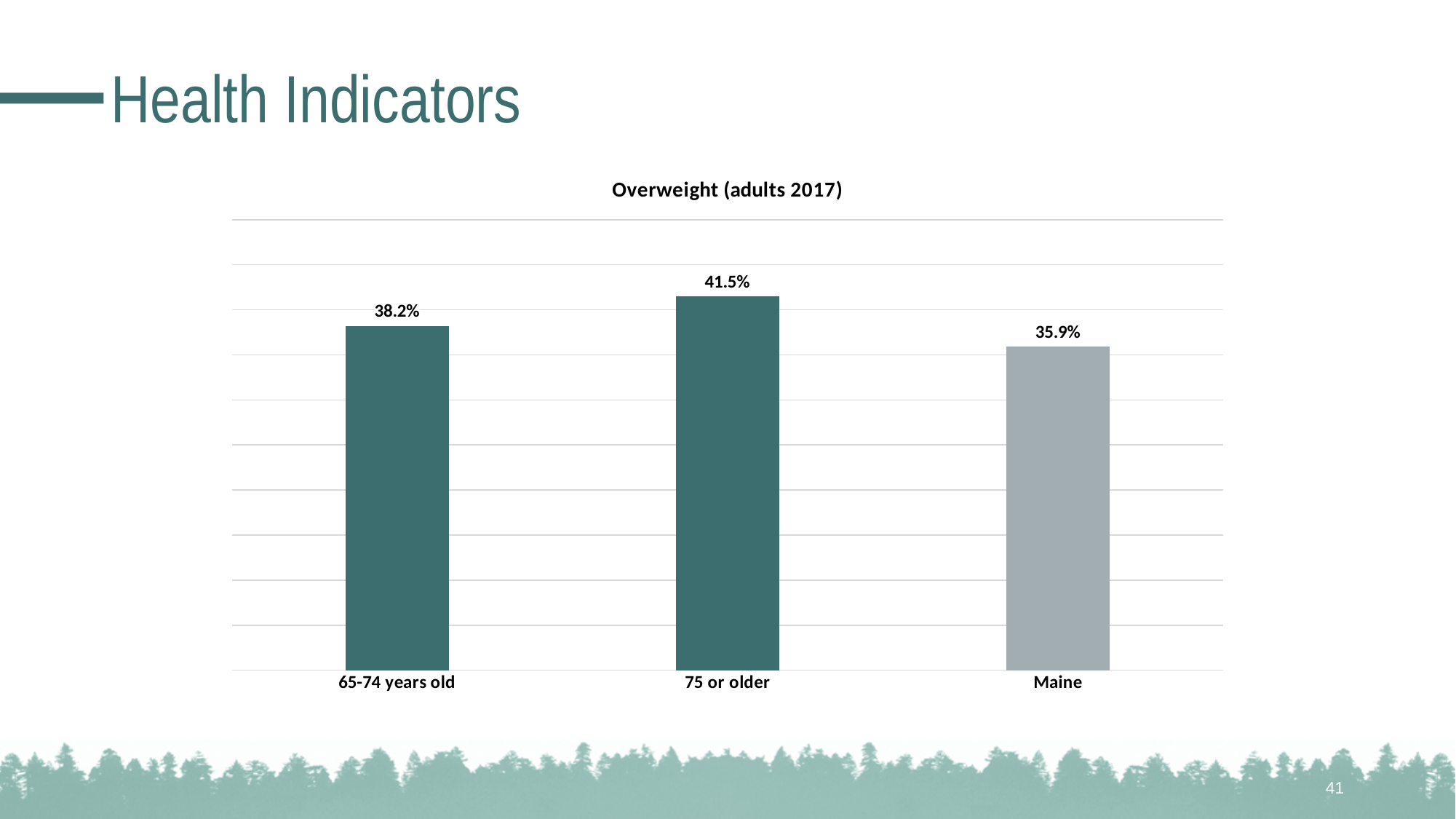
What is the overweight percentage for Maine? 35.9% What is the difference in overweight percentage between the 75 or older group and Maine? 5.6% Which has a higher overweight percentage, 65-74 years old or Maine? 65-74 years old What is the title of the chart? Overweight (adults 2017) What kind of chart is shown on the slide? Bar chart Which category has the lowest overweight percentage? Maine What is the difference in overweight percentage between the 75 or older group and the 65-74 years old group? 3.3% Which bar is shown in a different (grey) colour from the others? Maine What is the overweight percentage for adults 75 or older? 41.5% What is the overweight percentage for adults aged 65-74 years old? 38.2% Which category has the highest overweight percentage? 75 or older How many categories are shown in the chart? 3